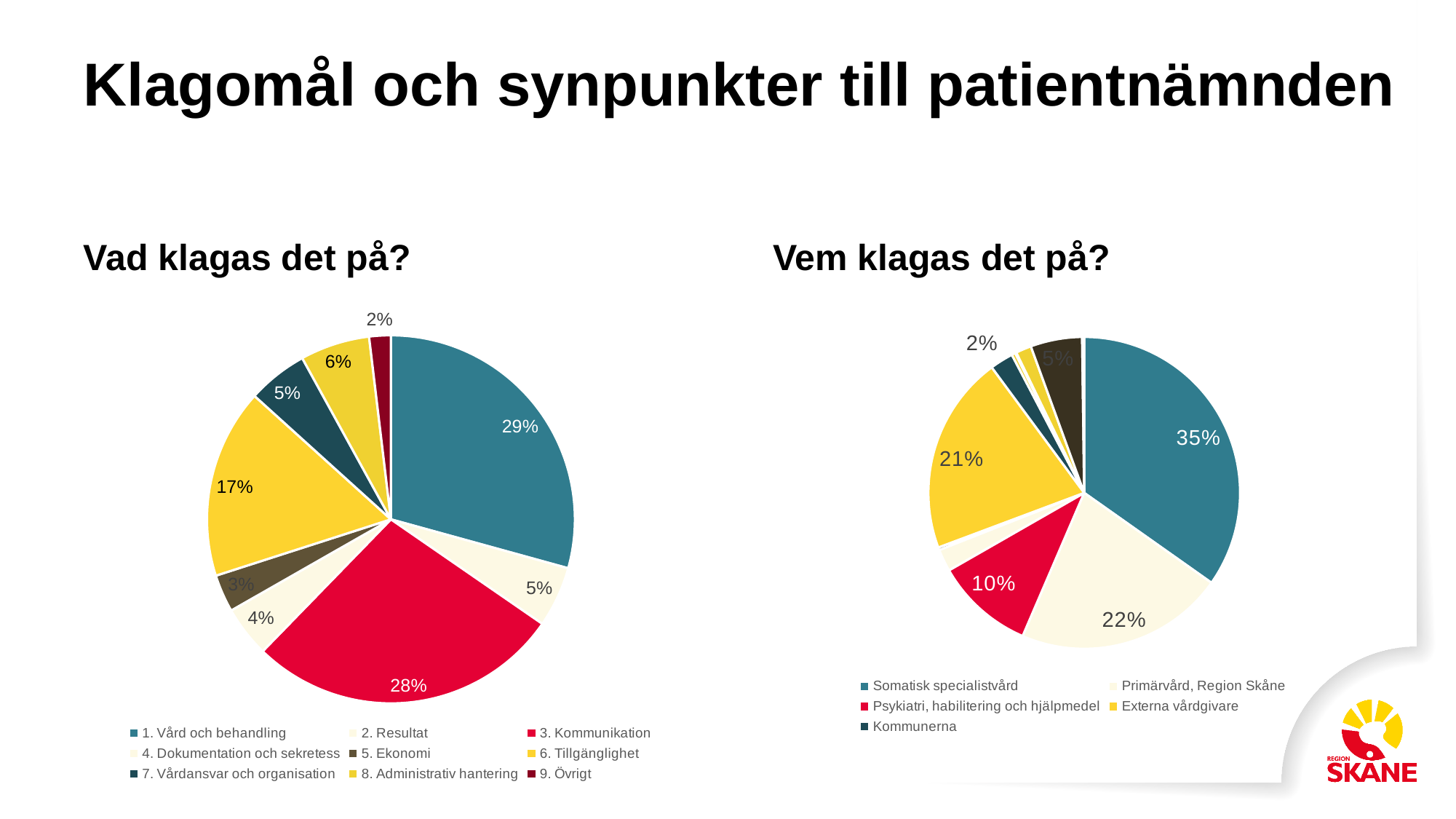
In the chart titled "Vad klagas det på?", which is larger: "6. Tillgänglighet" or "8. Administrativ hantering"? 6. Tillgänglighet In the chart titled "Vem klagas det på?", what share does "Psykiatri, habilitering och hjälpmedel" have? 10% In the chart titled "Vem klagas det på?", how many entries does the legend list? 5 In the chart titled "Vem klagas det på?", which legend category has the largest share? Somatisk specialistvård What kind of chart is shown under "Vem klagas det på?"? Pie chart In the chart titled "Vem klagas det på?", what is the difference between the shares of "Primärvård, Region Skåne" and "Externa vårdgivare"? 1% In the chart titled "Vem klagas det på?", what share does "Somatisk specialistvård" have? 35% In the chart titled "Vad klagas det på?", how many categories does the legend list? 9 In the chart titled "Vad klagas det på?", what is the difference between the shares of "1. Vård och behandling" and "3. Kommunikation"? 1% In the chart titled "Vad klagas det på?", which category has the smallest share? 9. Övrigt In the chart titled "Vad klagas det på?", what share does "1. Vård och behandling" have? 29%